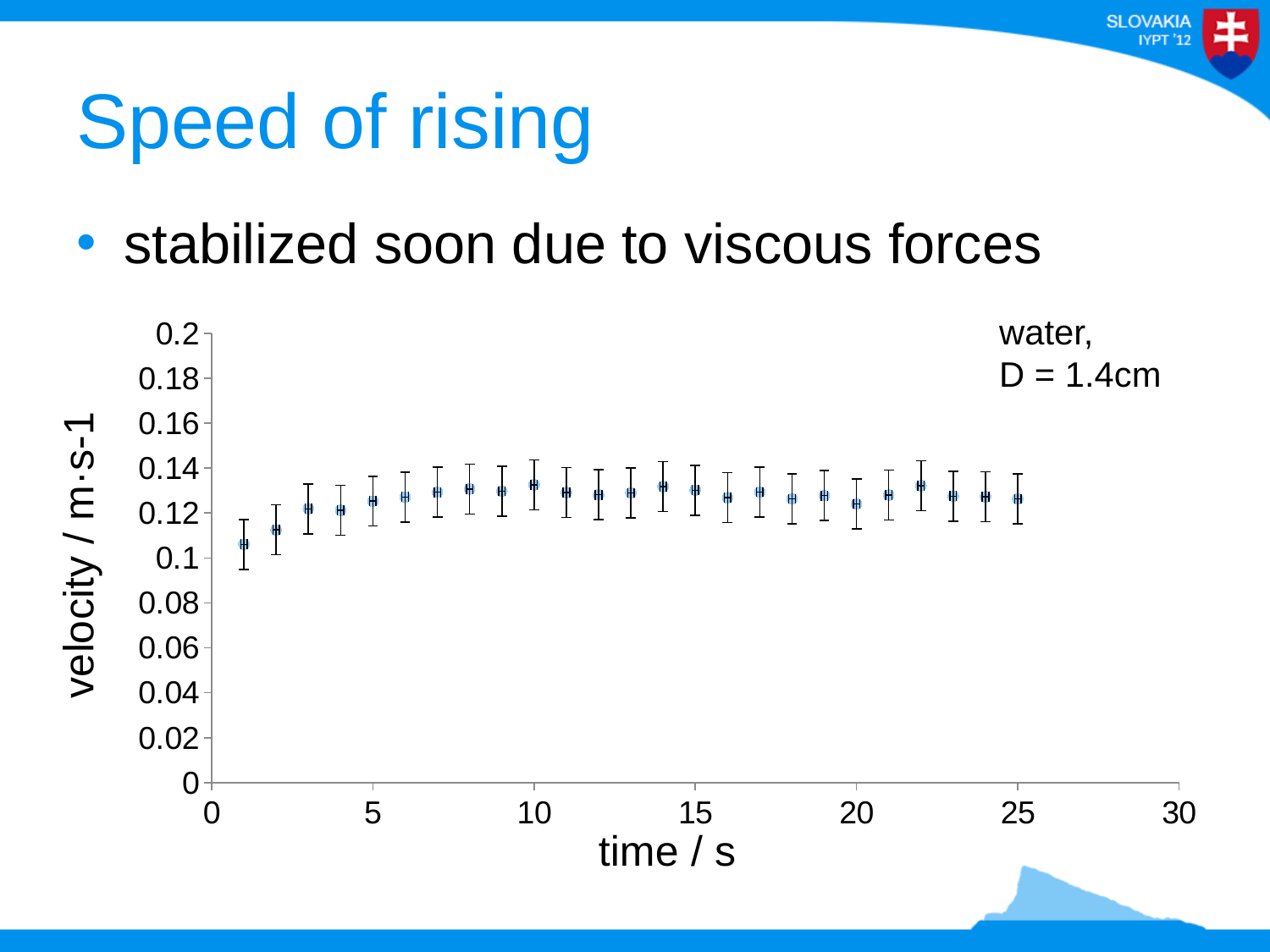
Is the velocity at 25 s greater or less than 0.1? greater What is the label of the x axis? time / s How many data points are plotted on the chart? 25 Is the velocity at 10 s greater or less than 0.12? greater How does the velocity change along the time axis? rises at first, then stabilizes Which is larger, the velocity at 1 s or the velocity at 10 s? 10 s What kind of chart is shown on the slide? scatter plot At which time is the velocity lowest? 1 s Is the velocity at 15 s greater or less than 0.14? less Which is larger, the velocity at 2 s or the velocity at 20 s? 20 s What is the label of the y axis? velocity / m·s-1